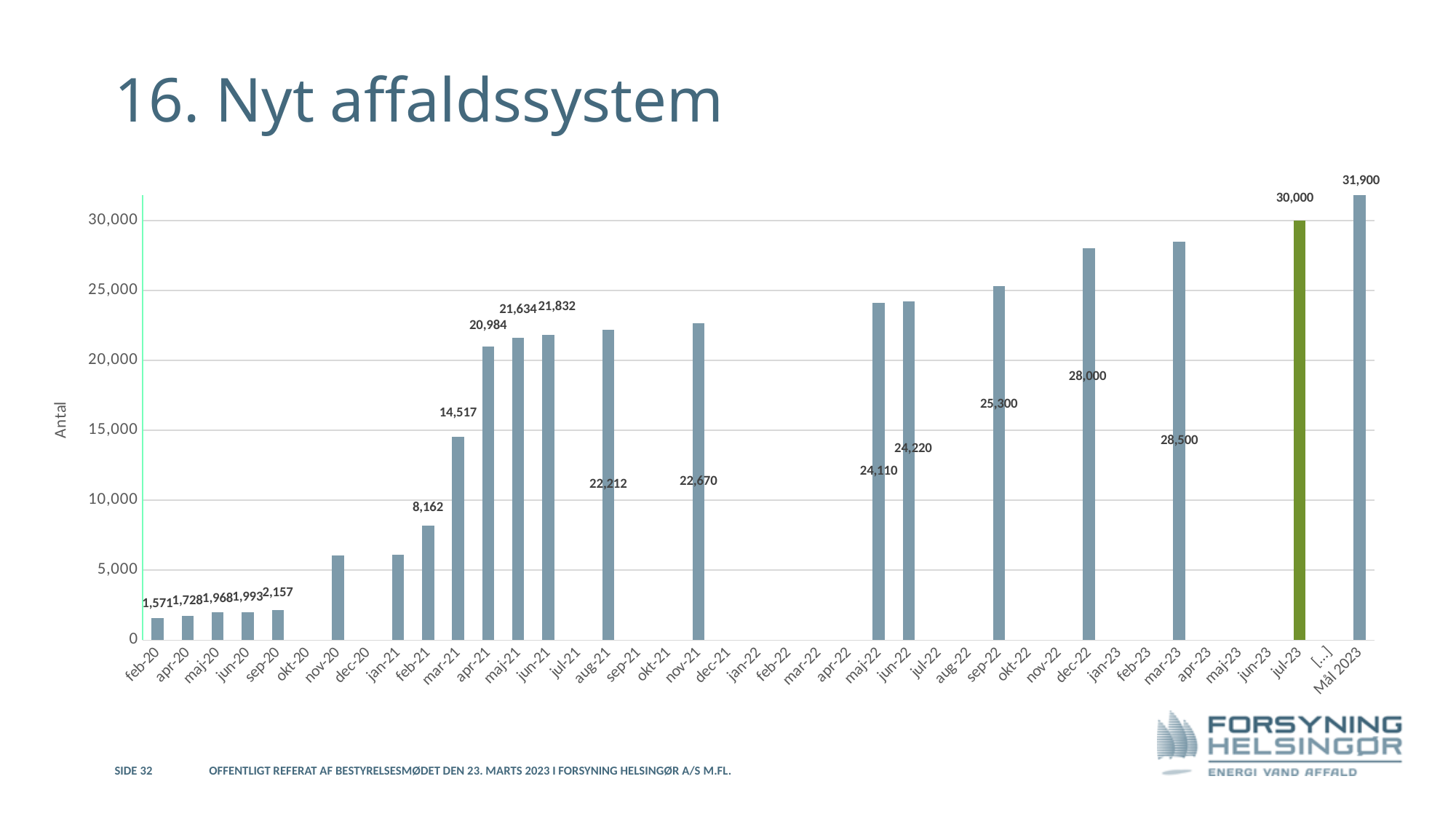
Which category's bar is coloured green? jul-23 What is the value for mar-21? 14,517 What kind of chart is shown on the slide? bar chart Do the values generally rise or fall from feb-20 to Mål 2023? rise Which category has the lowest value? feb-20 What is the value for feb-21? 8,162 Which category has the highest value? Mål 2023 What is the difference between the value for Mål 2023 and the value for jul-23? 1,900 What is the value for sep-22? 25,300 Is the value for nov-20 greater or less than 5,000? greater What is the value for Mål 2023? 31,900 Which is larger, the value for apr-21 or the value for nov-21? nov-21